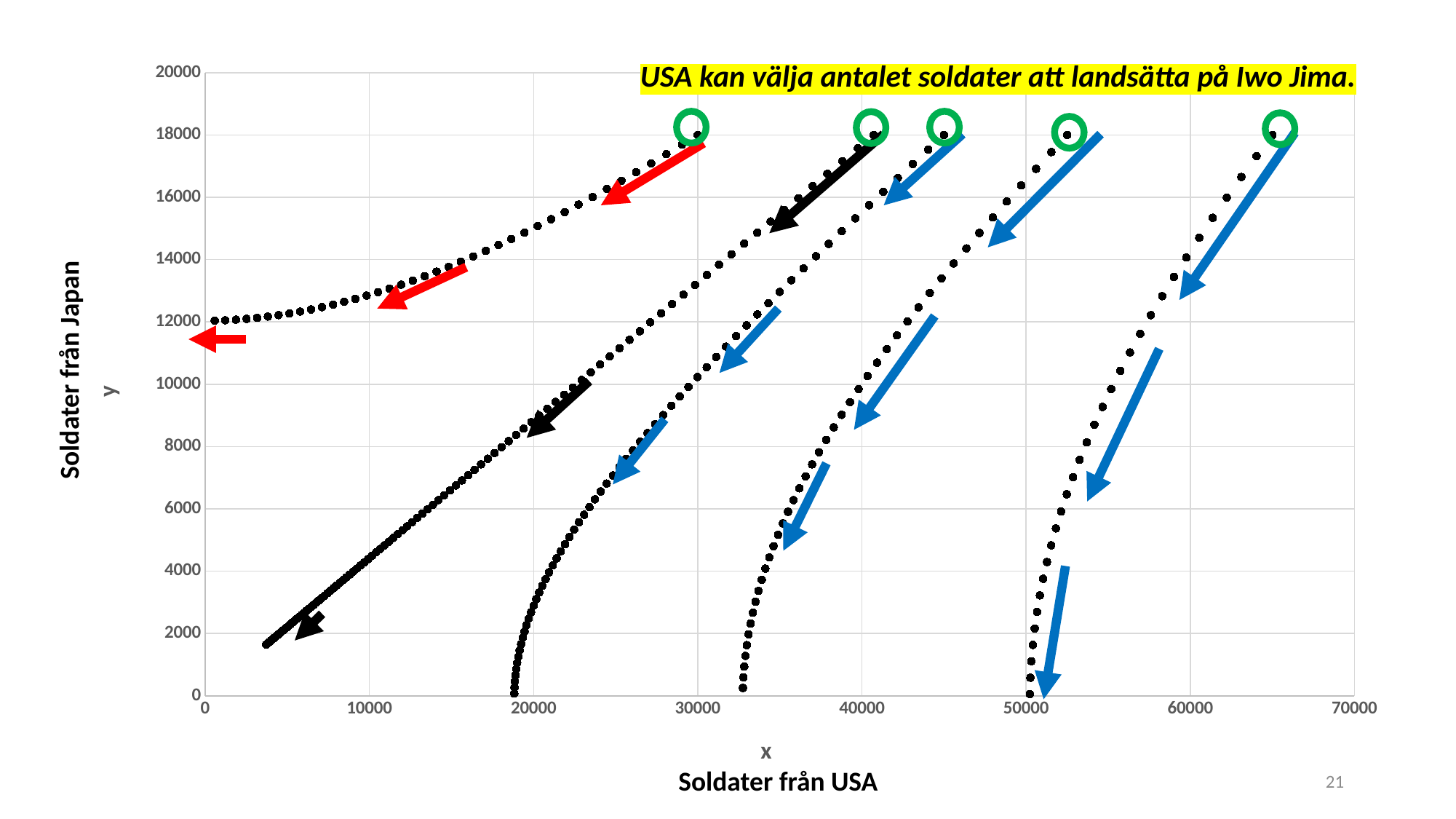
Is the x value at the lower end of the trajectory that starts near x = 40000 greater or less than 10000? less Which trajectory ends at a higher y value: the leftmost one (red arrows) or the one starting near x = 40000 (black arrows)? the leftmost one (red arrows) What is the label of the x axis? Soldater från USA Is the starting x value of the rightmost trajectory greater or less than 60000? greater What is the label of the y axis? Soldater från Japan Is the starting x value of the leftmost trajectory greater or less than 40000? less How many dotted trajectories (curves) are plotted on the chart? 5 Along the leftmost dotted trajectory, does the y value rise or fall as x increases? rise How many green circles mark starting points on the chart? 5 What kind of chart is shown on the slide? scatter chart